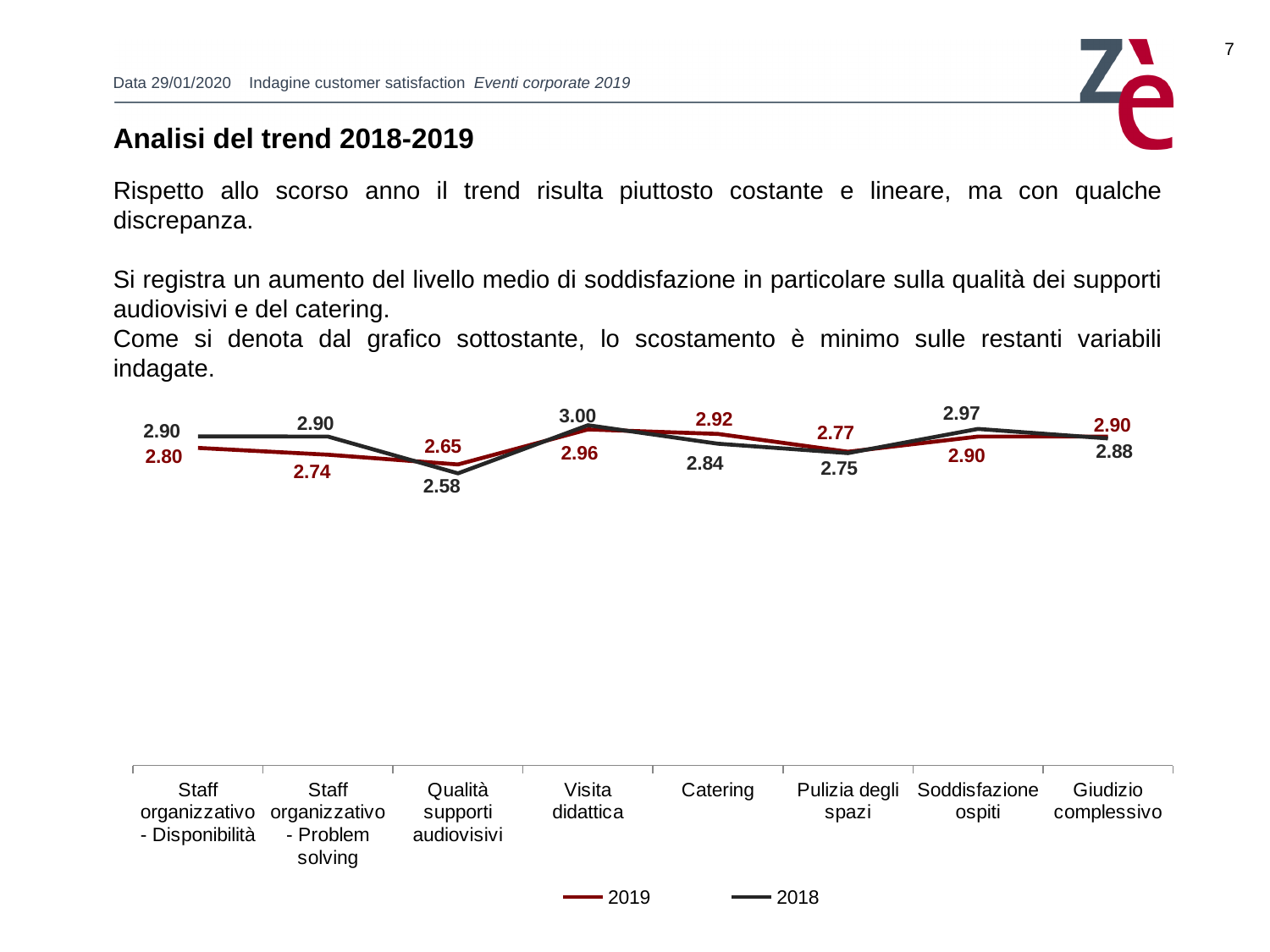
What is the 2019 value for Qualità supporti audiovisivi? 2.65 What is the 2018 value for Catering? 2.84 Which category has the lowest 2019 value? Qualità supporti audiovisivi How many series does the legend list? 2 What is the difference between the 2018 and 2019 values for Qualità supporti audiovisivi? 0.07 What kind of chart is shown on the slide? line chart Which category has the highest 2018 value? Visita didattica What is the difference between the 2019 and 2018 values for Catering? 0.08 What is the 2019 value for Staff organizzativo - Problem solving? 2.74 How many categories are plotted along the x axis? 8 Which colour is used for the 2019 series? red For Staff organizzativo - Disponibilità, which series has the larger value, 2019 or 2018? 2018